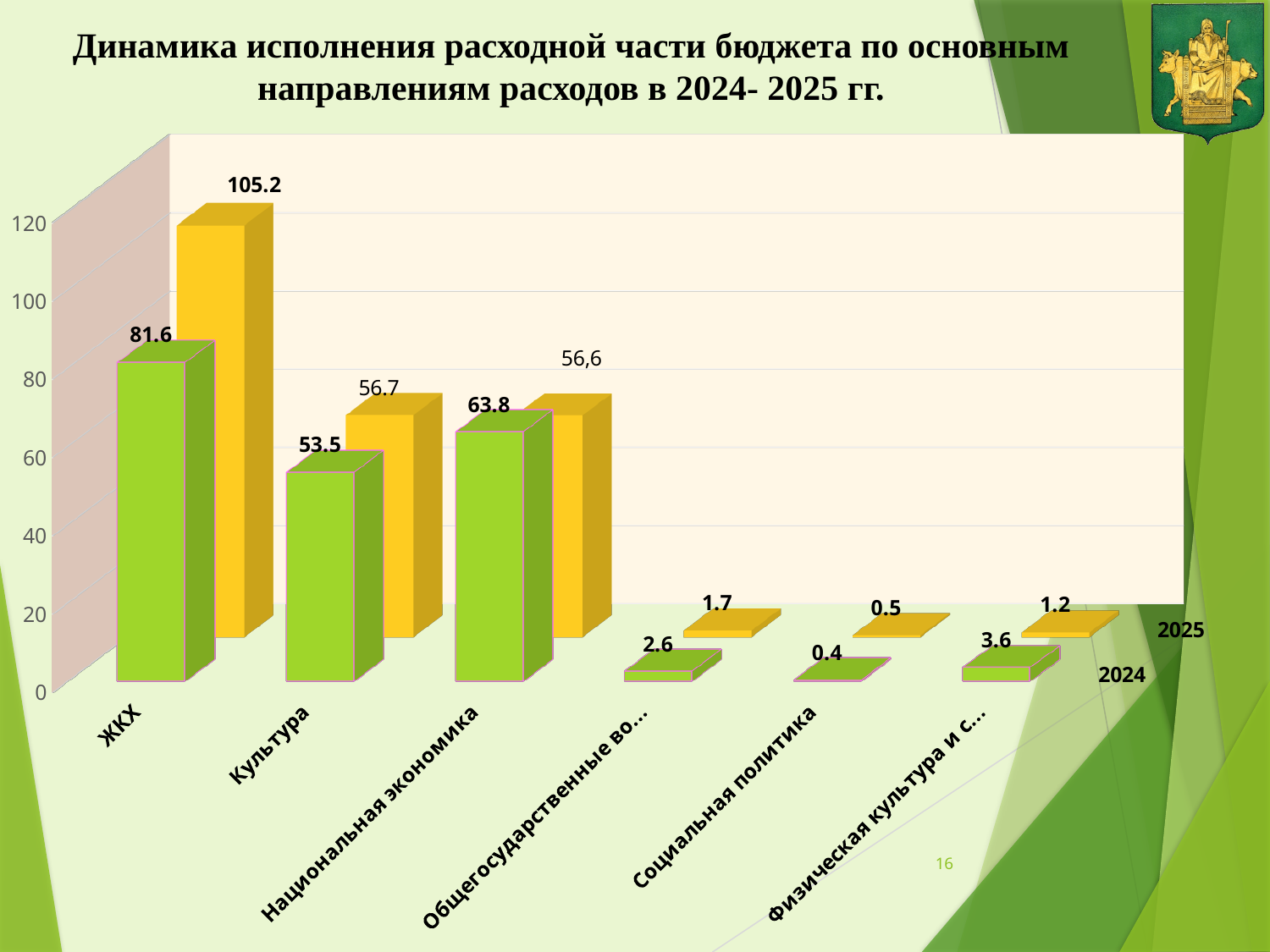
What is the value for Национальная экономика in 2025? 56,6 What is the value for Социальная политика in 2024? 0.4 What kind of chart is shown on the slide? Bar chart Which category has the lowest value in 2024? Социальная политика What is the difference between the 2025 and 2024 values for ЖКХ? 23.6 How many series does the chart show? 2 What is the value for Культура in 2024? 53.5 What is the value for ЖКХ in 2025? 105.2 For Национальная экономика, which year has the larger value, 2024 or 2025? 2024 Which category has the highest value in 2025? ЖКХ How many categories are shown on the x axis? 6 What is the value for ЖКХ in 2024? 81.6